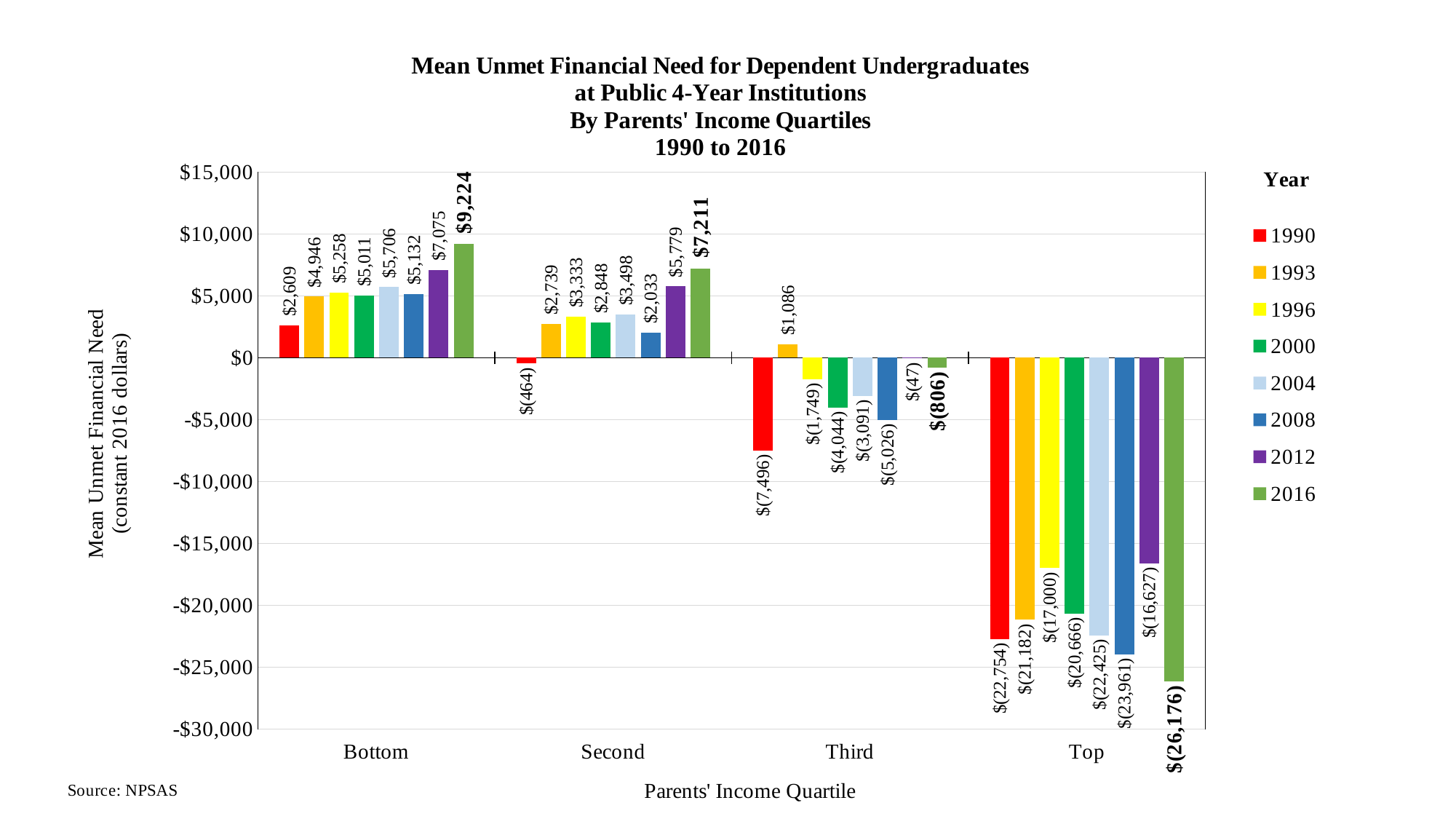
What is the value shown for the Top quartile in 2008? $(23,961) What is the value shown for the Third quartile in 1993? $1,086 Which is larger, the Second quartile value in 2012 or in 2016? 2016 What is the difference between the Bottom quartile and Second quartile values in 2016? $2,013 Which year has the lowest value in the Top quartile? 2016 Which year has the highest value in the Bottom quartile? 2016 What kind of chart is shown on the slide? Bar chart How many years does the legend list? 8 What is the mean unmet financial need for the Bottom quartile in 2016? $9,224 What is the value shown for the Second quartile in 1990? $(464) How many parents' income quartiles are shown on the x axis? 4 What is the difference between the Bottom quartile values for 2016 and 1990? $6,615